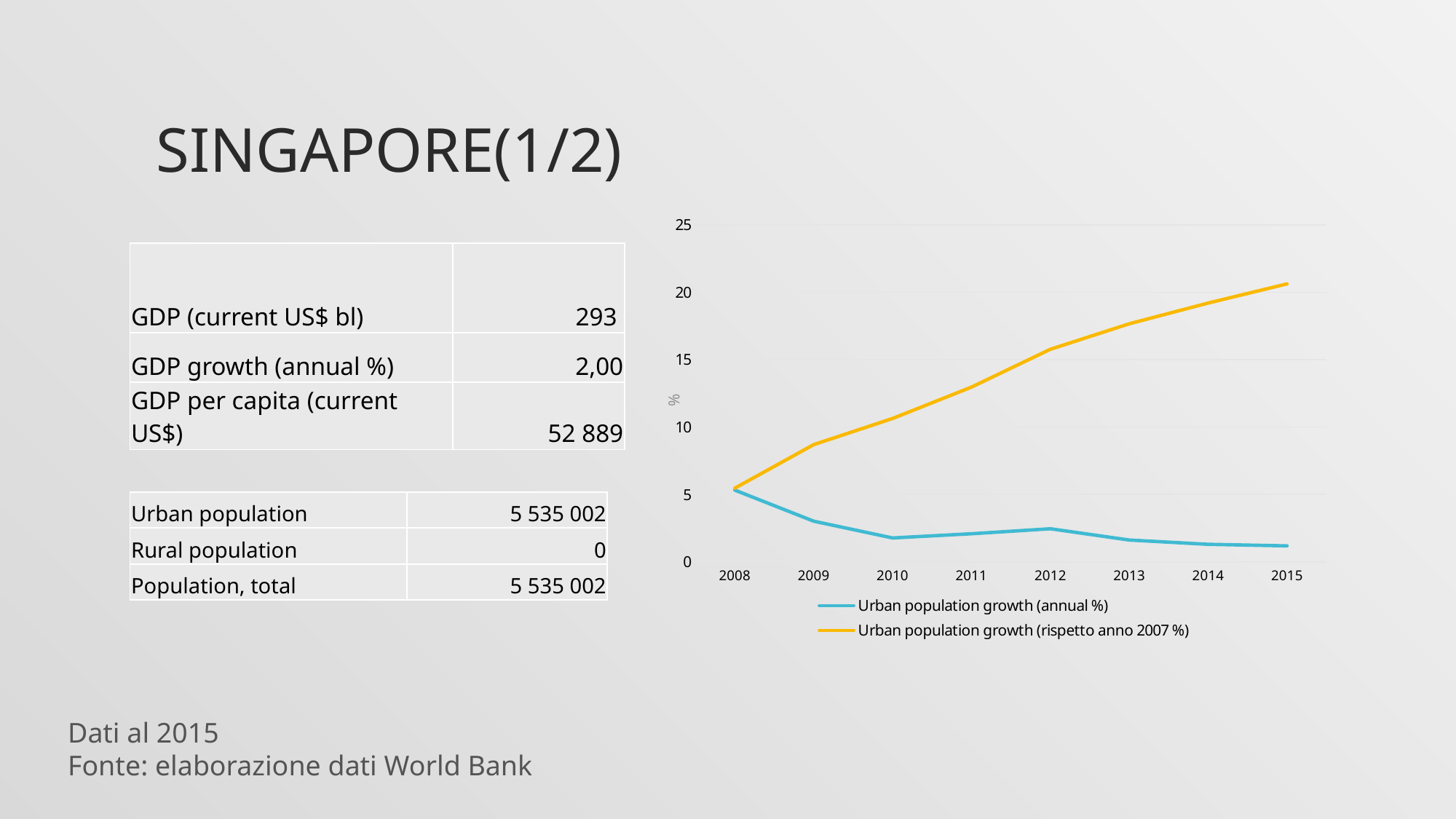
In which year is the 'Urban population growth (rispetto anno 2007 %)' series highest? 2015 Is the value for 'Urban population growth (annual %)' in 2010 greater or less than 5? less Is the value for 'Urban population growth (rispetto anno 2007 %)' in 2009 greater or less than 10? less How many series does the chart legend list? 2 In 2015, which series has the larger value: 'Urban population growth (annual %)' or 'Urban population growth (rispetto anno 2007 %)'? Urban population growth (rispetto anno 2007 %) Is the value for 'Urban population growth (rispetto anno 2007 %)' in 2012 greater or less than 15? greater In which year is the 'Urban population growth (annual %)' series highest? 2008 In which year is the 'Urban population growth (rispetto anno 2007 %)' series lowest? 2008 How many years are plotted along the x axis of the chart? 8 What kind of chart is shown on the slide? line chart Does the 'Urban population growth (annual %)' series rise or fall from 2008 to 2010? fall Does the 'Urban population growth (rispetto anno 2007 %)' series rise or fall from 2008 to 2015? rise